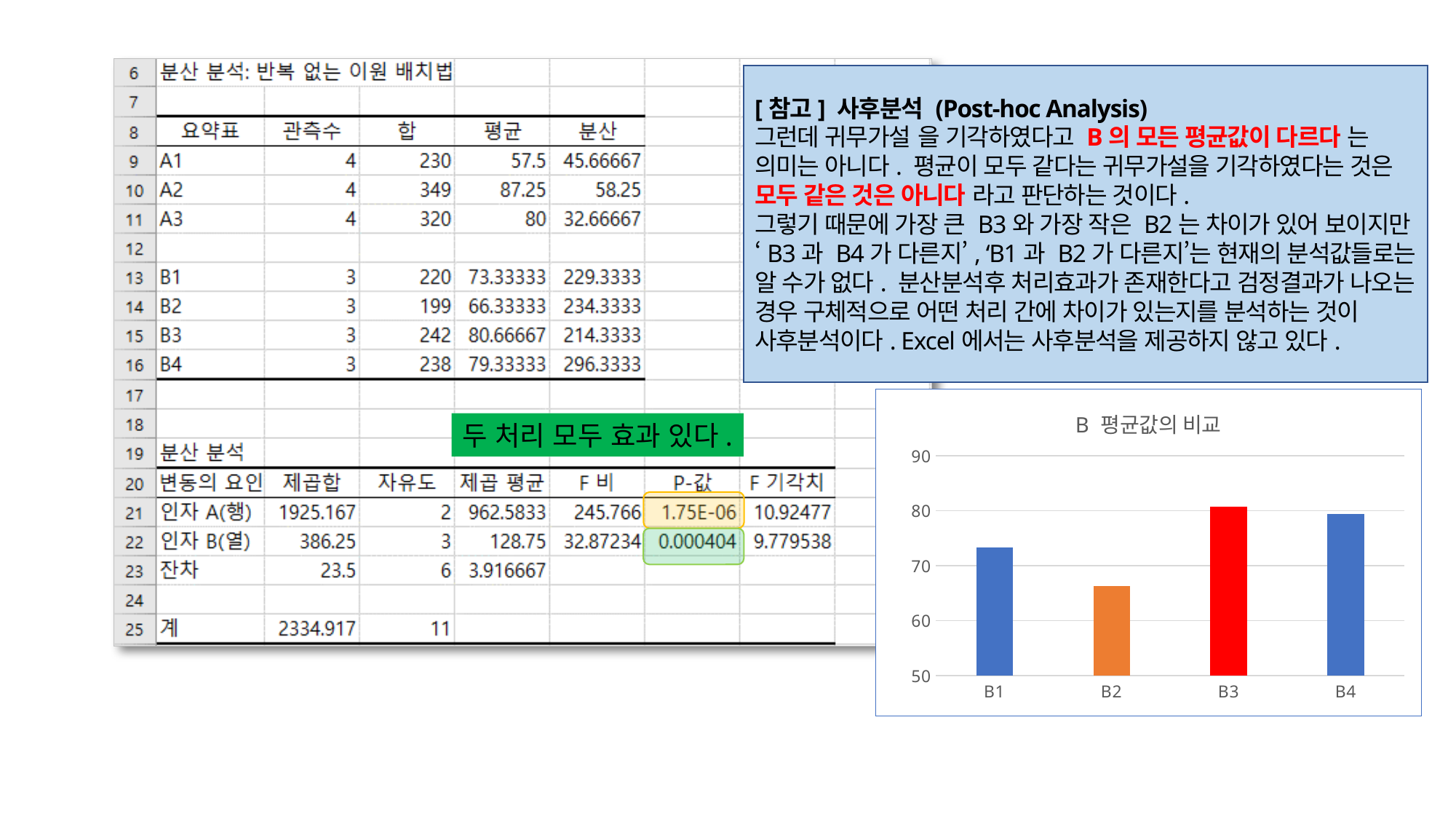
What colour is the bar for B3 in the chart? red Is the value for B1 greater or less than 70? greater Is the value for B4 greater or less than 70? greater Which category has the lowest bar in the chart? B2 Which is larger, the value for B4 or the value for B1? B4 Is the value for B2 greater or less than 70? less Which category has the highest bar in the chart? B3 Which is larger, the value for B1 or the value for B2? B1 What is the title of the chart? B 평균값의 비교 What kind of chart is shown on the slide? bar chart How many categories are plotted in the chart? 4